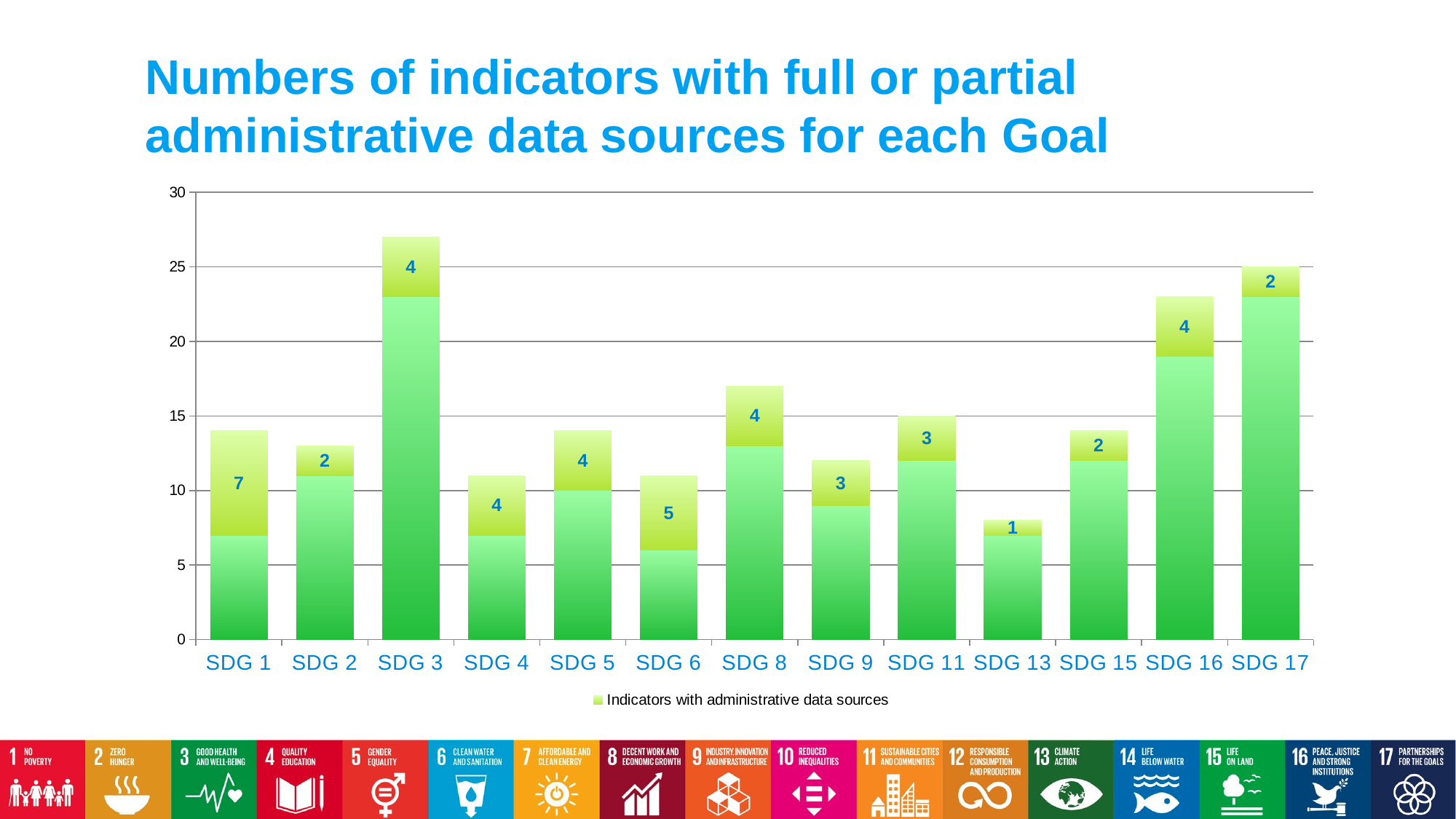
What is the labelled value of the 'Indicators with administrative data sources' segment for SDG 1? 7 Is the total height of the SDG 3 bar greater or less than 25? greater What is the difference between the labelled values for SDG 1 and SDG 13? 6 What is the labelled value of the 'Indicators with administrative data sources' segment for SDG 6? 5 Which has the larger labelled value, SDG 6 or SDG 2? SDG 6 Which SDG has the lowest labelled value for 'Indicators with administrative data sources'? SDG 13 What type of chart is shown on the slide? Stacked bar chart What is the labelled value of the 'Indicators with administrative data sources' segment for SDG 13? 1 Which SDG has the tallest bar overall in the chart? SDG 3 Which SDG has the highest labelled value for 'Indicators with administrative data sources'? SDG 1 How many series does the chart legend list? 1 How many SDG categories are shown on the x axis of the chart? 13